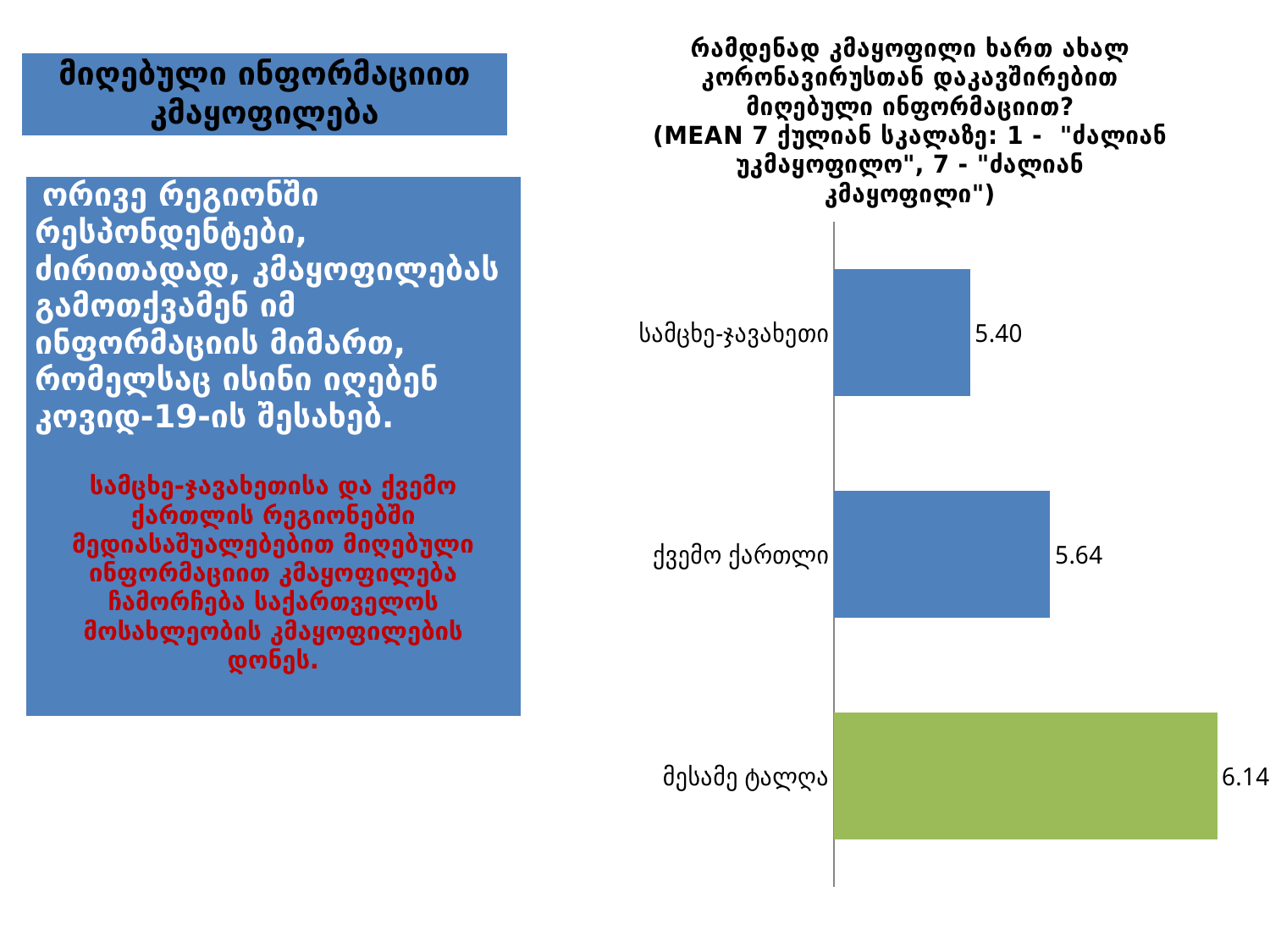
What is the value for ქვემო ქართლი? 5.64 What kind of chart is shown on the slide? Bar chart What is the difference between the values for მესამე ტალღა and სამცხე-ჯავახეთი? 0.74 Which category has the lowest value? სამცხე-ჯავახეთი Which is larger, the value for ქვემო ქართლი or the value for სამცხე-ჯავახეთი? ქვემო ქართლი How many categories are shown in the chart? 3 What is the difference between the values for ქვემო ქართლი and სამცხე-ჯავახეთი? 0.24 How many bars in the chart are blue? 2 Which category has the highest value? მესამე ტალღა What is the value for სამცხე-ჯავახეთი? 5.40 What colour is the bar for მესამე ტალღა? Green What is the value for მესამე ტალღა? 6.14